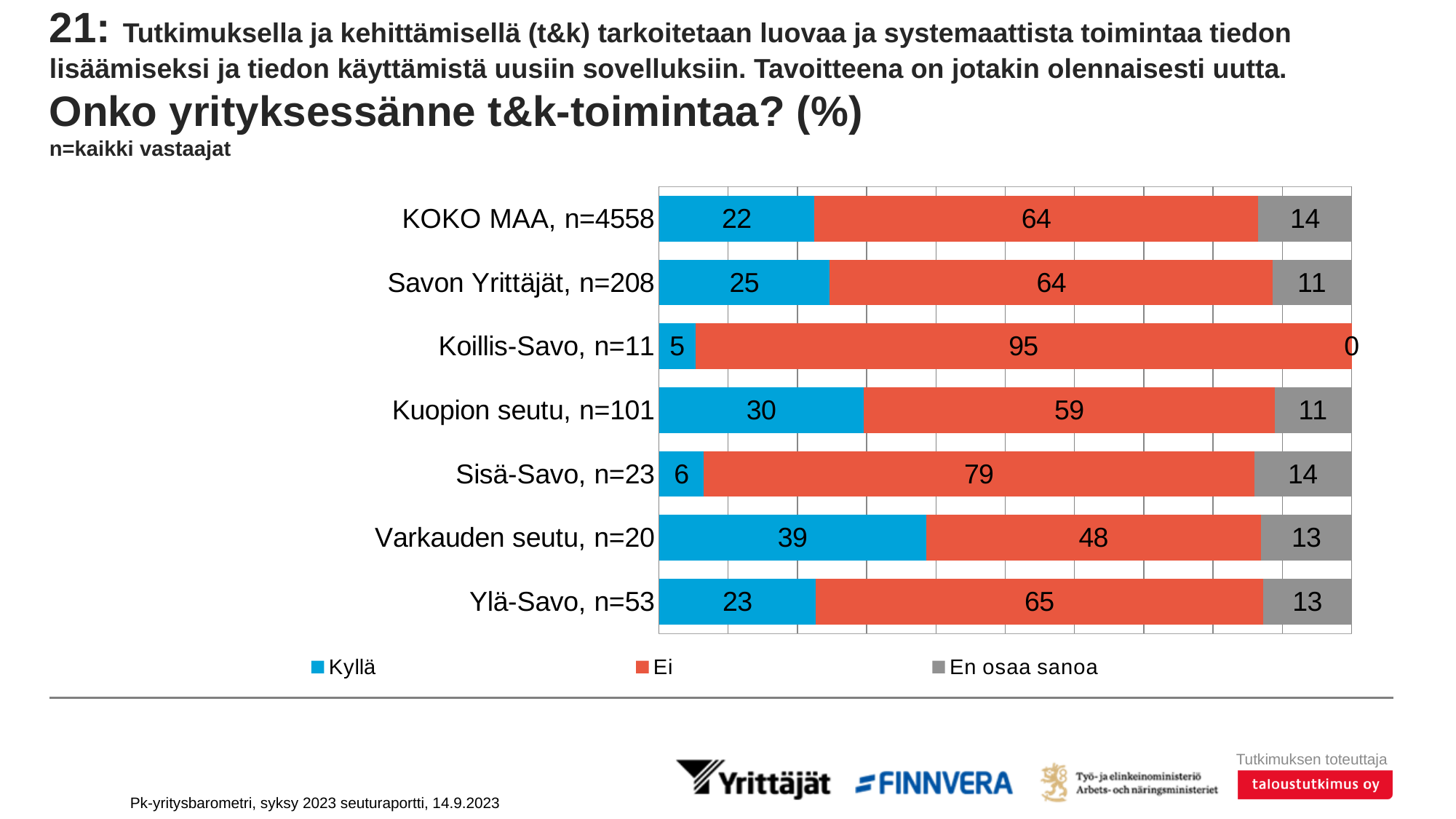
How many series does the legend list? 3 What is the total of the stacked bar for KOKO MAA, n=4558? 100 Which category has the highest 'Kyllä' value? Varkauden seutu, n=20 What kind of chart is shown on the slide? Stacked bar chart How many categories are shown in the chart? 7 Which colour represents the 'Ei' series in the chart? Red Which is larger, the 'Kyllä' value for Savon Yrittäjät, n=208 or for Ylä-Savo, n=53? Savon Yrittäjät, n=208 What is the 'En osaa sanoa' value for Savon Yrittäjät, n=208? 11 What is the 'Kyllä' value for Kuopion seutu, n=101? 30 What is the 'Ei' value for Sisä-Savo, n=23? 79 What is the difference between the 'Ei' values for Koillis-Savo, n=11 and Varkauden seutu, n=20? 47 Which category has the lowest 'Kyllä' value? Koillis-Savo, n=11